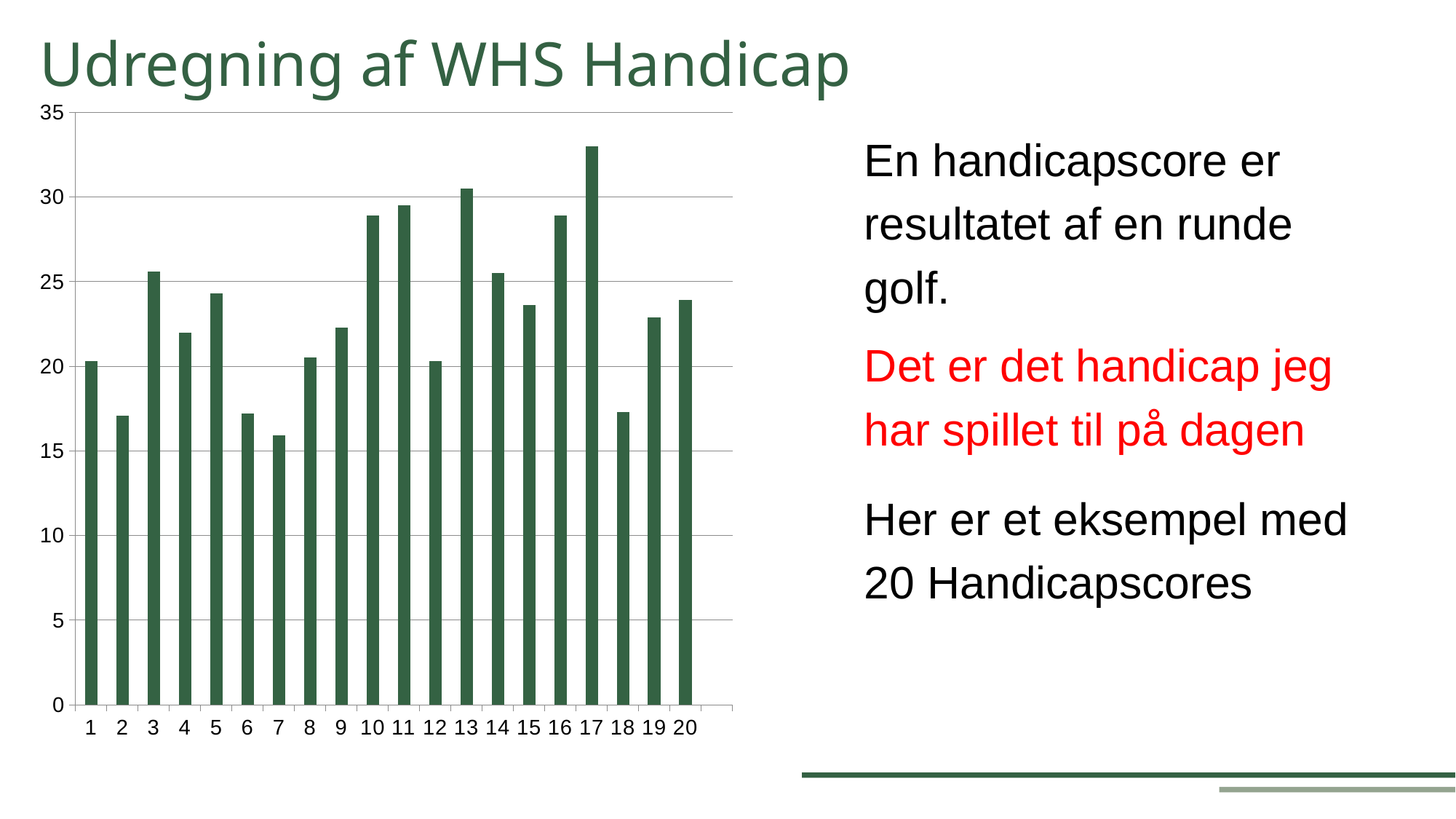
Is the value for category 17 greater or less than 30? greater Which category has the highest bar in the chart? 17 What is the highest value shown on the vertical axis of the chart? 35 Which category has the lowest bar in the chart? 7 Is the value for category 18 greater or less than 20? less How many bars (handicap scores) are plotted in the chart? 20 Is the value for category 7 greater or less than 20? less Which is larger, the value for category 11 or the value for category 15? 11 What kind of chart is shown on the slide? bar chart Which is larger, the value for category 3 or the value for category 2? 3